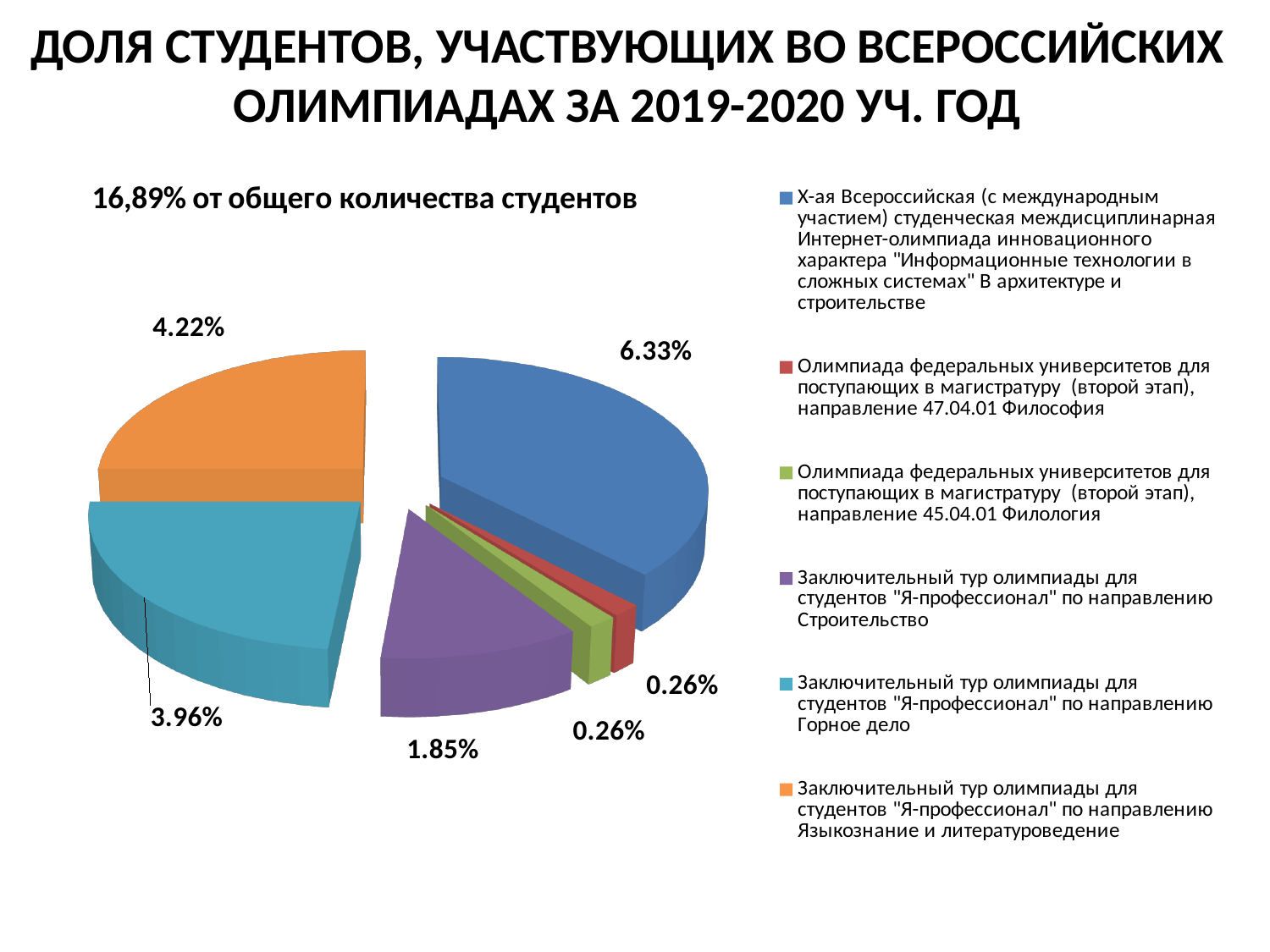
What is the value for the slice "Заключительный тур олимпиады для студентов "Я-профессионал" по направлению Горное дело"? 3.96% How many slices does the pie chart have? 6 What is the value for the slice "Заключительный тур олимпиады для студентов "Я-профессионал" по направлению Строительство"? 1.85% What is the title shown above the pie chart? 16,89% от общего количества студентов What is the value for the slice "Олимпиада федеральных университетов для поступающих в магистратуру (второй этап), направление 47.04.01 Философия"? 0.26% What is the value for the slice "Заключительный тур олимпиады для студентов "Я-профессионал" по направлению Языкознание и литературоведение"? 4.22% Which is larger: the slice for Языкознание и литературоведение or the slice for Горное дело? Языкознание и литературоведение What kind of chart is shown on the slide? pie chart What is the difference between the largest slice (6.33%) and the slice for Языкознание и литературоведение (4.22%)? 2.11% How many entries does the legend list? 6 What is the smallest value shown on the pie chart? 0.26% Which slice of the pie chart is the largest? Х-ая Всероссийская (с международным участием) студенческая междисциплинарная Интернет-олимпиада инновационного характера "Информационные технологии в сложных системах" В архитектуре и строительстве